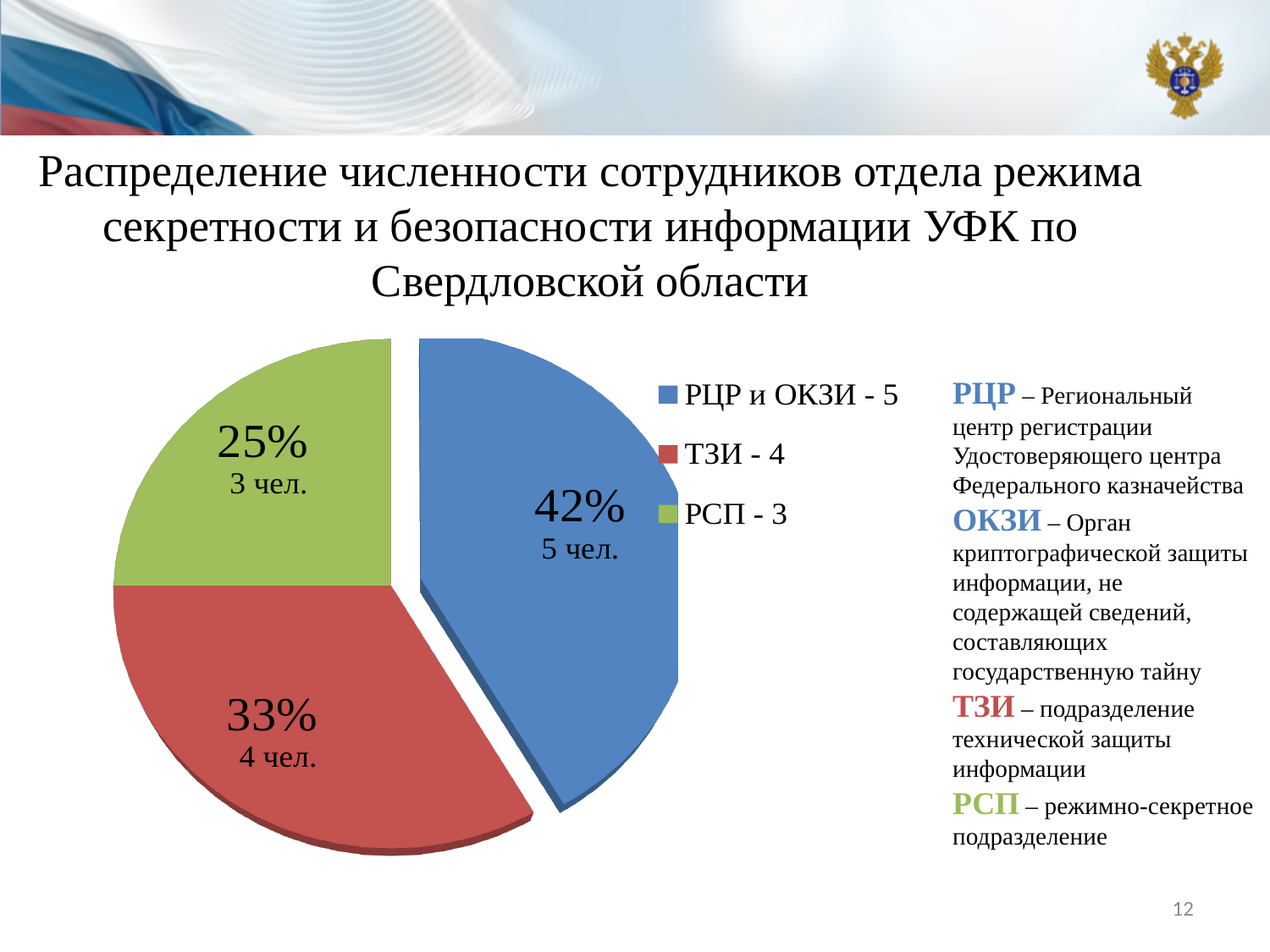
How many employees (чел.) are in the РСП slice? 3 чел. What is the difference in employees between the РЦР и ОКЗИ slice and the РСП slice? 2 чел. Which slice is the largest? РЦР и ОКЗИ Which slice is the smallest? РСП What percentage share does the ТЗИ slice have? 33% What kind of chart is shown on the slide? pie chart How many employees (чел.) are in the ТЗИ slice? 4 чел. How many entries does the legend list? 3 Which colour is used for the ТЗИ slice? red What percentage share does the РЦР и ОКЗИ slice have? 42% How many slices does the pie chart have? 3 What percentage share does the РСП slice have? 25%